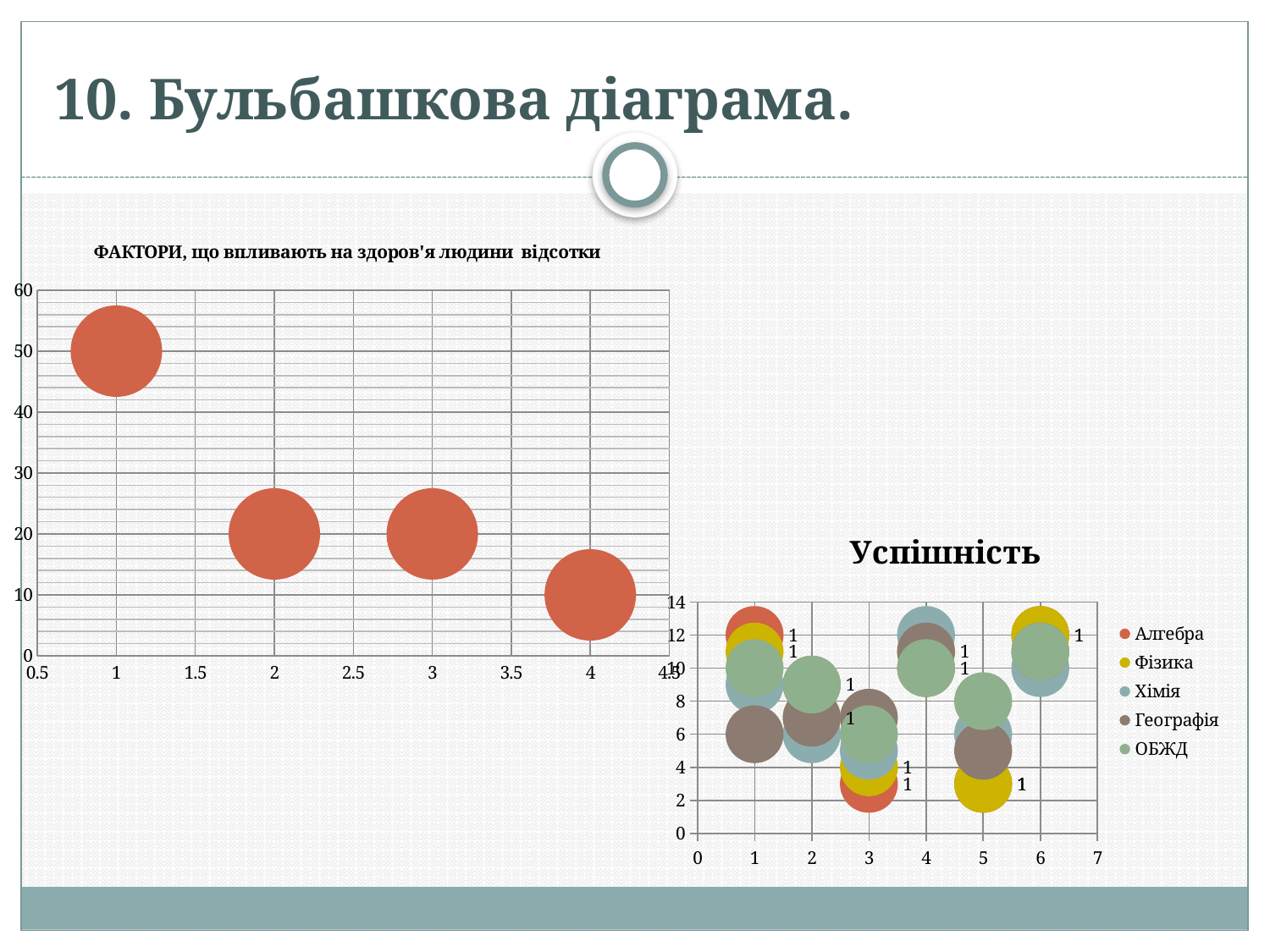
In the chart titled 'Успішність', which series is shown in yellow? Фізика In the chart 'ФАКТОРИ, що впливають на здоров'я людини відсотки', at which x value is the bubble with the highest y value? 1 In the chart 'ФАКТОРИ, що впливають на здоров'я людини відсотки', is the y value of the bubble at x = 2 greater or less than 30? less How many series does the legend of the chart titled 'Успішність' list? 5 What type of chart is the chart titled 'ФАКТОРИ, що впливають на здоров'я людини відсотки'? Bubble chart In the chart 'ФАКТОРИ, що впливають на здоров'я людини відсотки', at which x value is the bubble with the lowest y value? 4 In the chart 'ФАКТОРИ, що впливають на здоров'я людини відсотки', do the y values generally rise or fall as x increases? fall In the chart 'ФАКТОРИ, що впливають на здоров'я людини відсотки', what is the y value of the bubble at x = 1? 50 In the chart 'ФАКТОРИ, що впливають на здоров'я людини відсотки', what is the difference between the y values of the bubbles at x = 1 and x = 4? 40 In the chart 'ФАКТОРИ, що впливають на здоров'я людини відсотки', how many bubbles are plotted? 4 In the chart titled 'Успішність', is the y value of the Фізика bubble at x = 5 greater or less than 4? less In the chart 'ФАКТОРИ, що впливають на здоров'я людини відсотки', what is the y value of the bubble at x = 4? 10